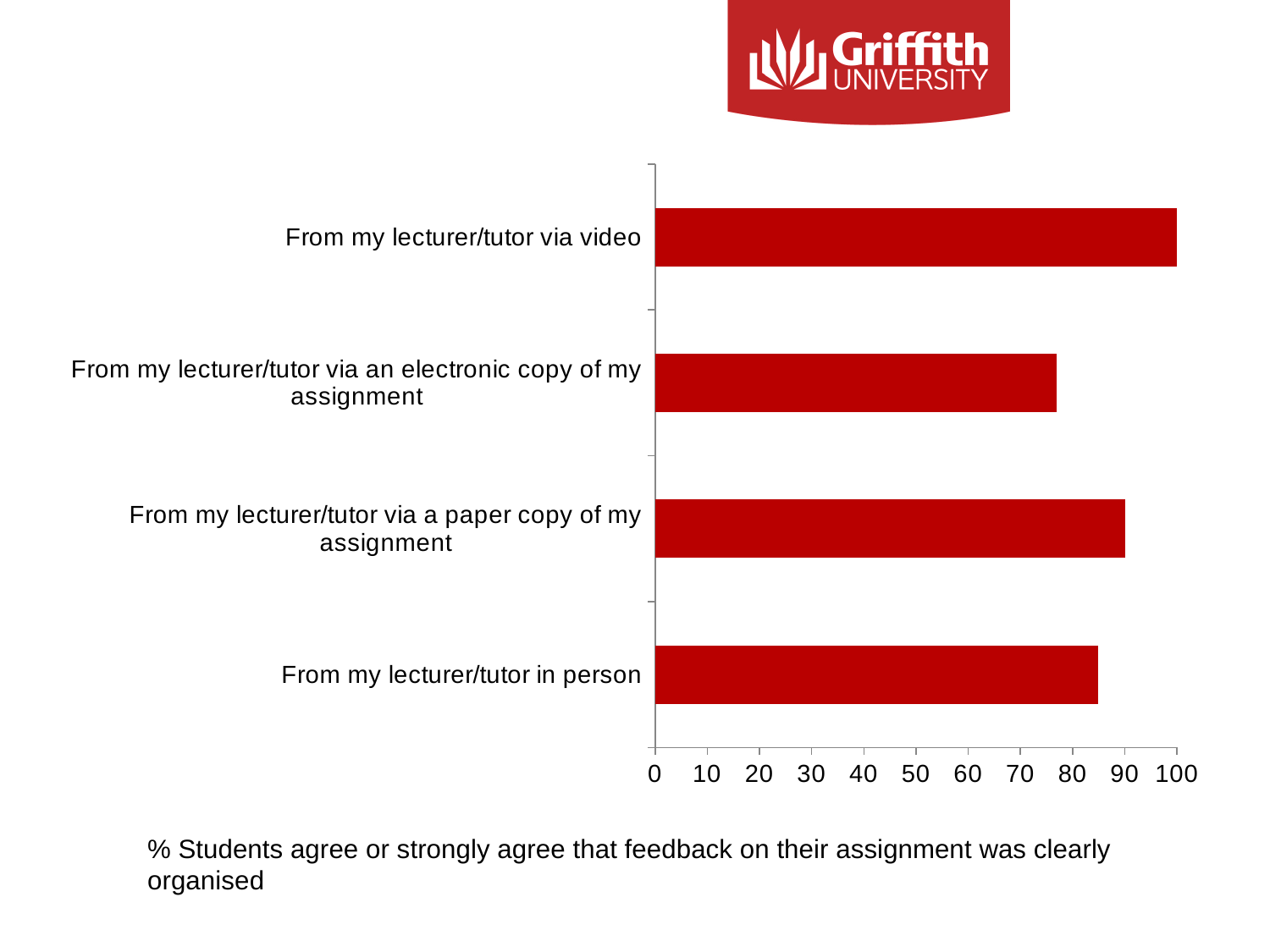
What is the value for 'From my lecturer/tutor via video'? 100 What is the value for 'From my lecturer/tutor via a paper copy of my assignment'? 90 What colour are the bars in the chart? red Which feedback method has the lowest percentage of students agreeing that feedback was clearly organised? From my lecturer/tutor via an electronic copy of my assignment Which is larger: the value for 'From my lecturer/tutor in person' or 'From my lecturer/tutor via an electronic copy of my assignment'? From my lecturer/tutor in person How many categories (feedback methods) are plotted in the chart? 4 Is the value for 'From my lecturer/tutor in person' greater or less than 90? less Is the value for 'From my lecturer/tutor via an electronic copy of my assignment' greater or less than 80? less What kind of chart is shown on the slide? bar chart Which feedback method has the highest percentage of students agreeing that feedback was clearly organised? From my lecturer/tutor via video Is the value for 'From my lecturer/tutor in person' greater or less than 80? greater Which is larger: the value for 'From my lecturer/tutor via a paper copy of my assignment' or 'From my lecturer/tutor in person'? From my lecturer/tutor via a paper copy of my assignment